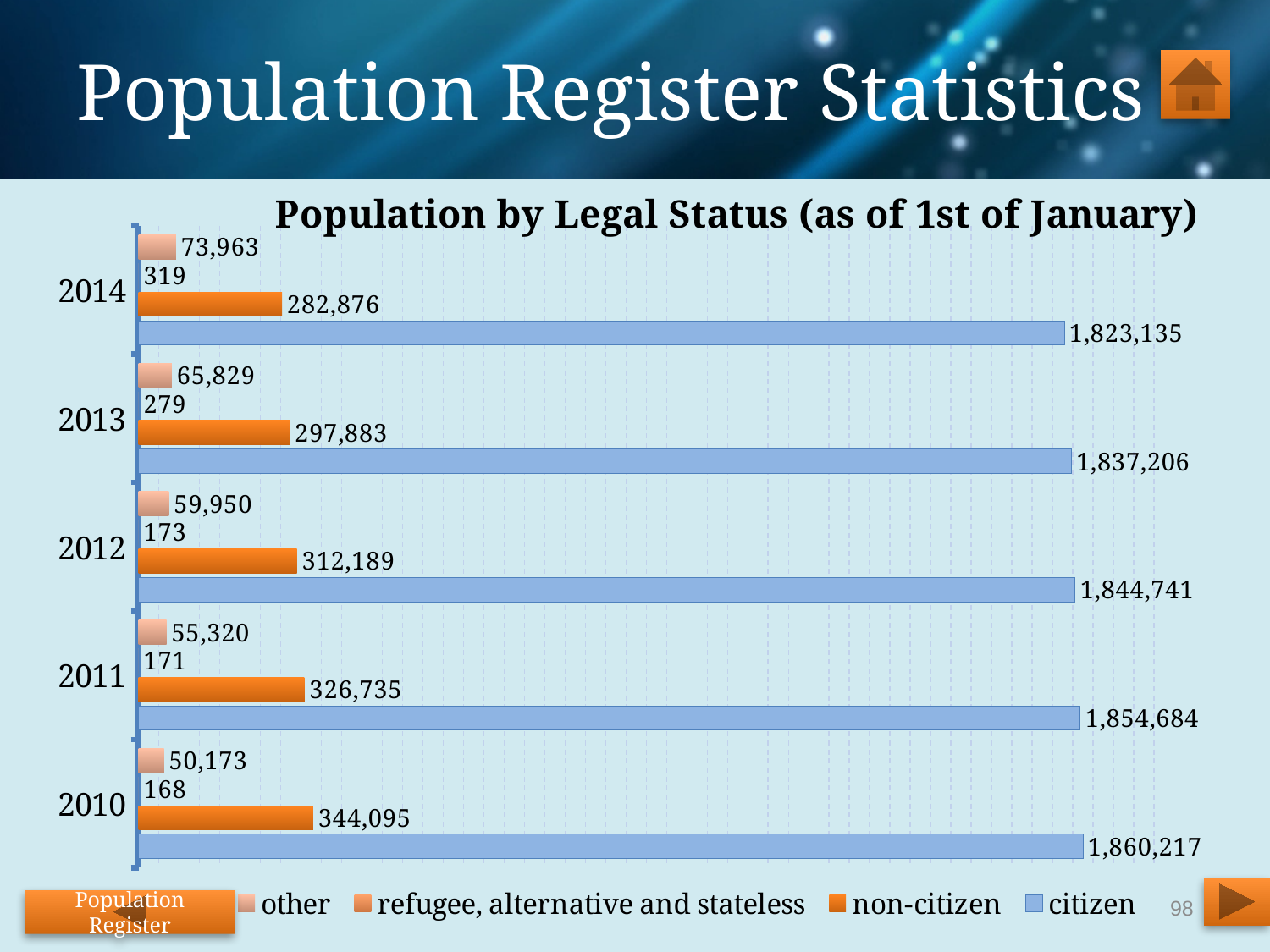
In which year is the number of non-citizens lowest? 2014 How many years are shown on the chart? 5 Does the number of citizens rise or fall from 2010 to 2014? fall What is the value for 'other' in 2013? 65,829 What is the title of the chart? Population by Legal Status (as of 1st of January) What is the number of non-citizens in 2010? 344,095 How many series does the legend list? 4 In which year is the number of citizens highest? 2010 What type of chart is shown on the slide? bar chart What is the value for 'refugee, alternative and stateless' in 2012? 173 What is the difference between the number of non-citizens in 2010 and in 2014? 61,219 What is the number of citizens in 2014? 1,823,135